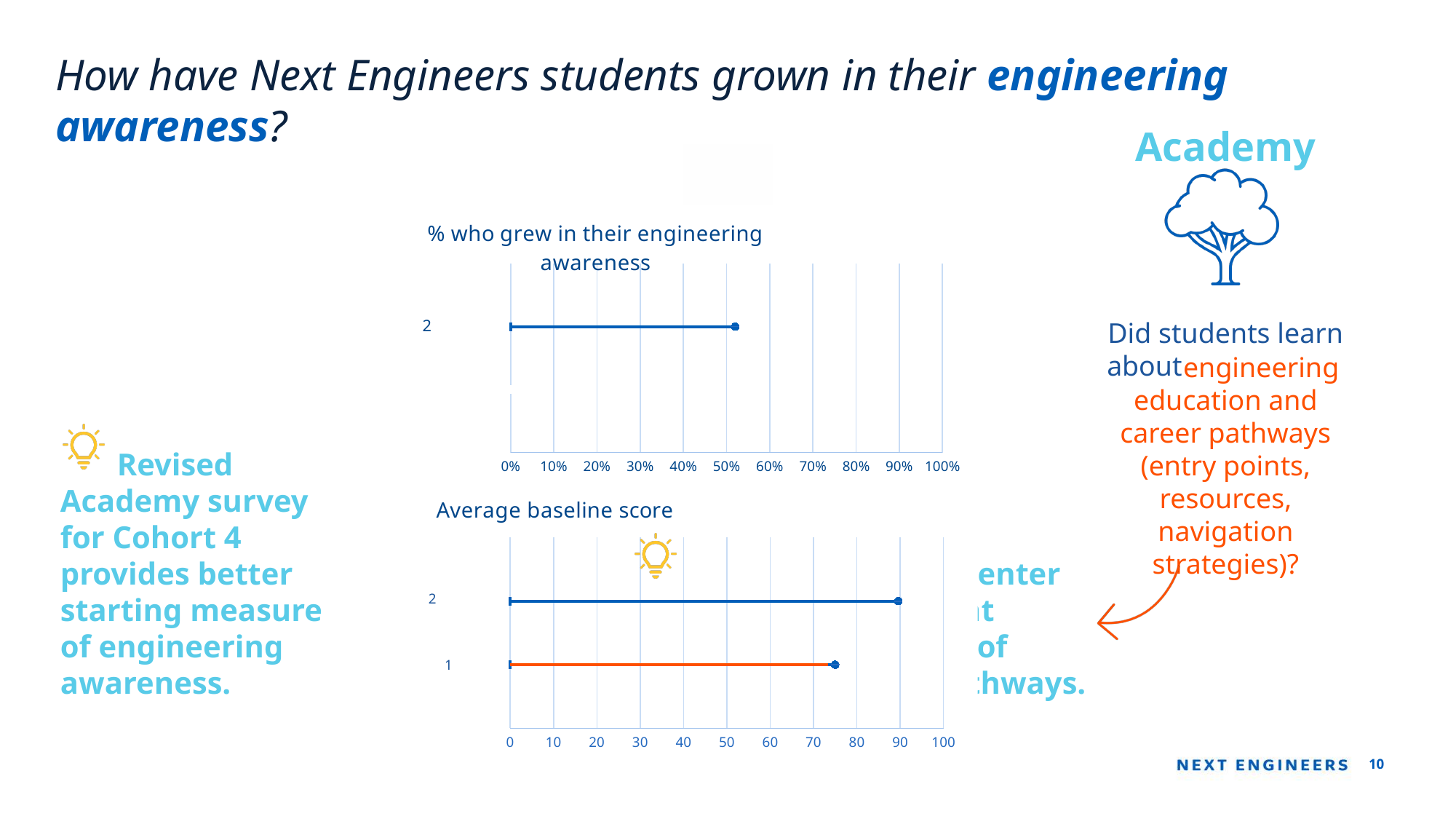
On the 'Average baseline score' chart, which category has the higher value, 1 or 2? 2 On the '% who grew in their engineering awareness' chart, is the value for category 2 greater or less than 60%? less What is the maximum value shown on the x axis of the '% who grew in their engineering awareness' chart? 100% What is the title of the lower chart on the slide? Average baseline score On the 'Average baseline score' chart, is the value for category 2 greater or less than 80? greater On the 'Average baseline score' chart, which category has the highest value? 2 How many categories are shown on the '% who grew in their engineering awareness' chart? 1 How many categories are shown on the 'Average baseline score' chart? 2 On the 'Average baseline score' chart, is the value for category 1 greater or less than 70? greater On the 'Average baseline score' chart, which category has the lowest value? 1